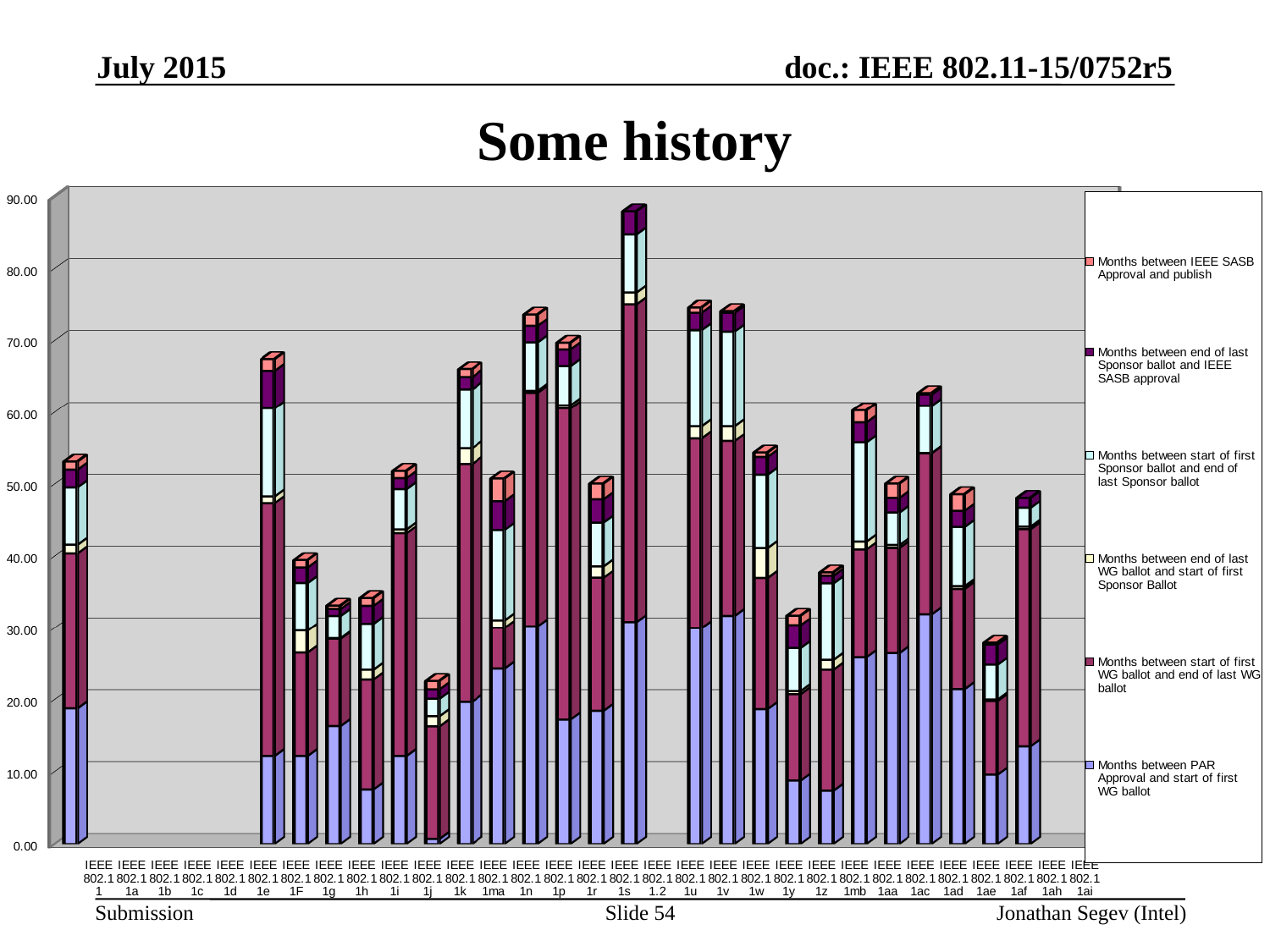
Is the total for IEEE 802.11s greater or less than 80? greater Is the total for IEEE 802.11j greater or less than 30? less Is the total for IEEE 802.11ae greater or less than 30? less Which has the taller stacked bar, IEEE 802.11k or IEEE 802.11g? IEEE 802.11k Which category has the tallest stacked bar? IEEE 802.11s What kind of chart is shown on the slide? stacked bar chart Which has the taller stacked bar, IEEE 802.11e or IEEE 802.11F? IEEE 802.11e How many categories are labelled along the x axis? 31 How many series does the legend list? 6 What is the title of the chart? Some history